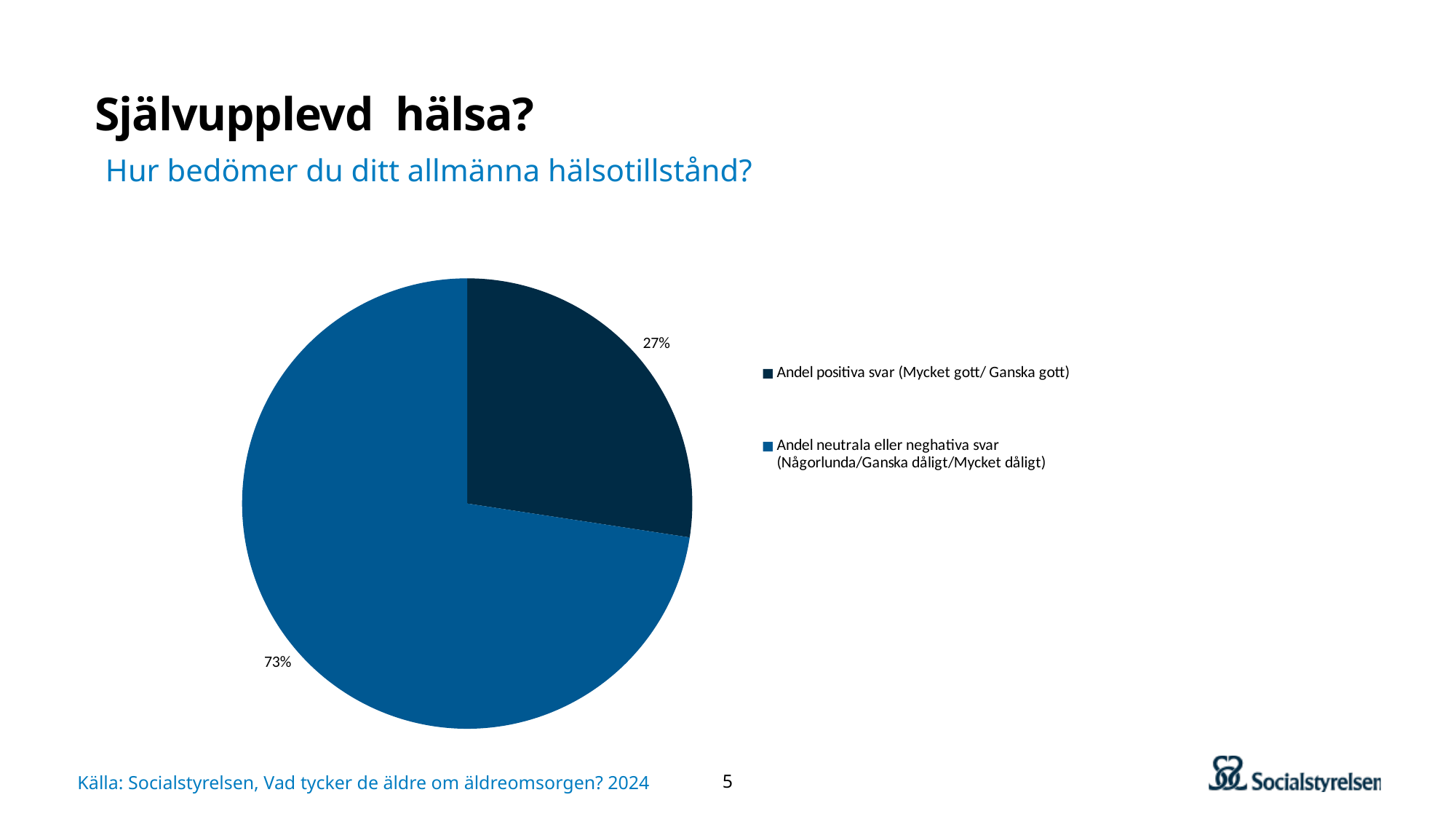
What question is the pie chart answering, as shown in the blue subtitle? Hur bedömer du ditt allmänna hälsotillstånd? What is the difference in percentage points between the neutral/negative slice and the positive slice? 46 Which slice of the pie is the smallest? Andel positiva svar (Mycket gott/ Ganska gott) How many slices does the pie chart have? 2 Which legend entry is shown in the darker navy colour? Andel positiva svar (Mycket gott/ Ganska gott) What share of the pie is labelled "Andel positiva svar (Mycket gott/ Ganska gott)"? 27% Which is larger: the share of positive answers or the share of neutral or negative answers? Andel neutrala eller neghativa svar What is the total of the two slices shown in the pie chart? 100% How many entries does the legend list? 2 What share of the pie is labelled "Andel neutrala eller neghativa svar (Någorlunda/Ganska dåligt/Mycket dåligt)"? 73% What kind of chart is shown on the slide? pie chart Which slice of the pie is the largest? Andel neutrala eller neghativa svar (Någorlunda/Ganska dåligt/Mycket dåligt)